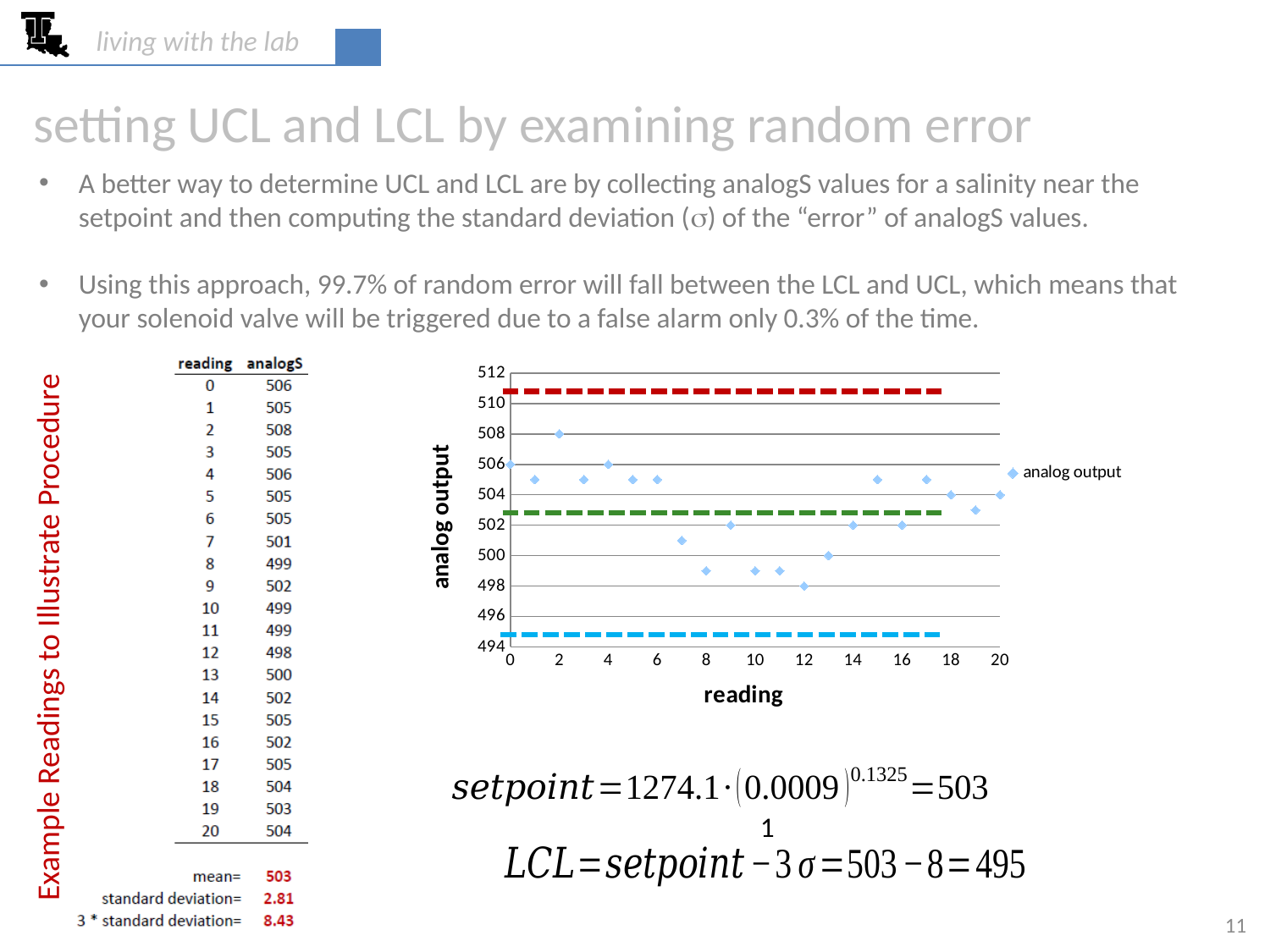
What is the name of the series shown in the chart legend? analog output What is the difference between the analog output at reading 2 and at reading 12? 10 What is the analog output value at reading 12? 498 How many data points are plotted for the analog output series? 21 At which reading is the analog output highest in the chart? 2 At which reading is the analog output lowest in the chart? 12 Which has a larger analog output, reading 2 or reading 12? reading 2 What is the title of the chart's x axis? reading How many series does the chart legend list? 1 What kind of chart is shown on the slide? scatter chart Is the analog output at reading 4 greater or less than 504? greater What is the analog output value at reading 2? 508